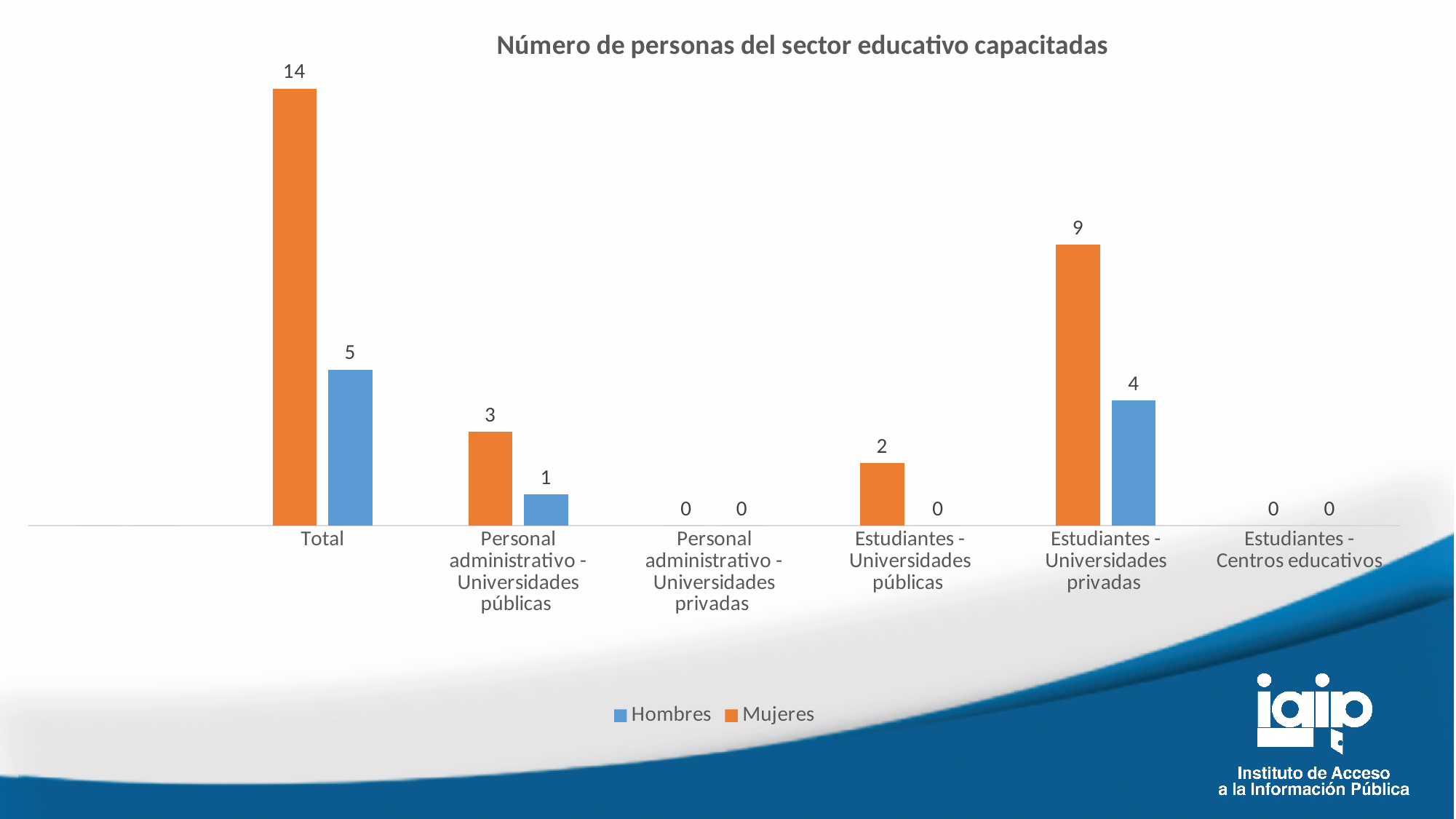
What is the difference between the Mujeres and Hombres values in the Estudiantes - Universidades privadas category? 5 What is the value for Mujeres in the Estudiantes - Universidades privadas category? 9 Excluding the Total category, which category has the highest value for Mujeres? Estudiantes - Universidades privadas How many categories are shown on the x axis? 6 What is the value for Hombres in the Total category? 5 What is the title of the chart? Número de personas del sector educativo capacitadas Which is larger in the Personal administrativo - Universidades públicas category, Hombres or Mujeres? Mujeres How many series does the legend list? 2 What is the value for Hombres in the Personal administrativo - Universidades públicas category? 1 What is the value for Mujeres in the Total category? 14 What is the difference between the Mujeres and Hombres values in the Total category? 9 What is the value for Mujeres in the Estudiantes - Universidades públicas category? 2